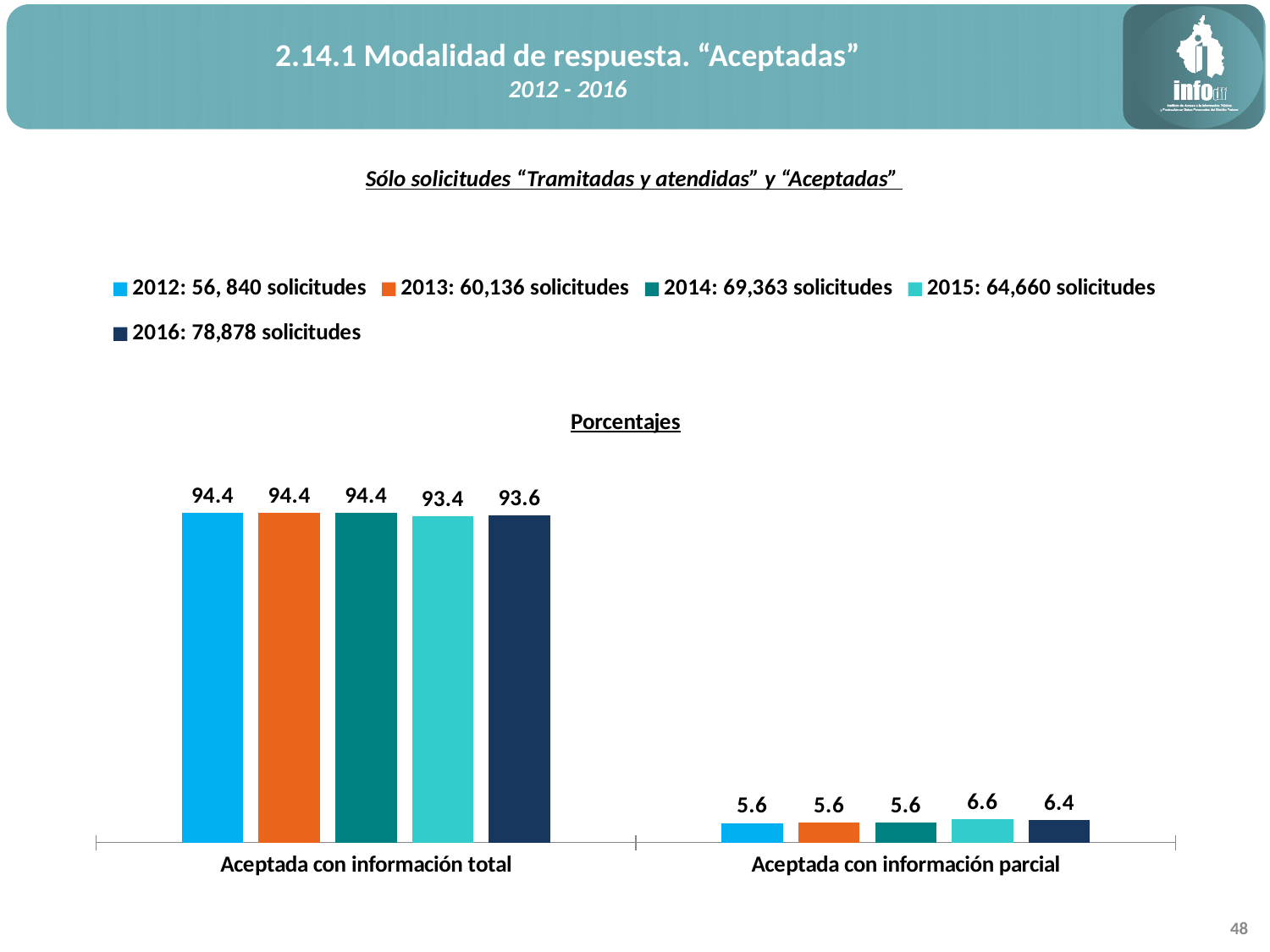
Which is larger: the 2016 value for "Aceptada con información parcial" or the 2014 value for "Aceptada con información parcial"? 2016 What kind of chart is shown on the slide? bar chart What is the difference between the 2012 and 2015 values in the "Aceptada con información total" category? 1.0 Which year has the highest value in the "Aceptada con información parcial" category? 2015 What is the title shown above the chart? Porcentajes What is the value for 2016 in the "Aceptada con información total" category? 93.6 According to the legend, how many solicitudes were there in 2014? 69,363 What is the value for 2015 in the "Aceptada con información parcial" category? 6.6 Which year has the lowest value in the "Aceptada con información total" category? 2015 What is the value for 2012 in the "Aceptada con información total" category? 94.4 How many series does the legend list? 5 How many categories are shown on the x axis? 2